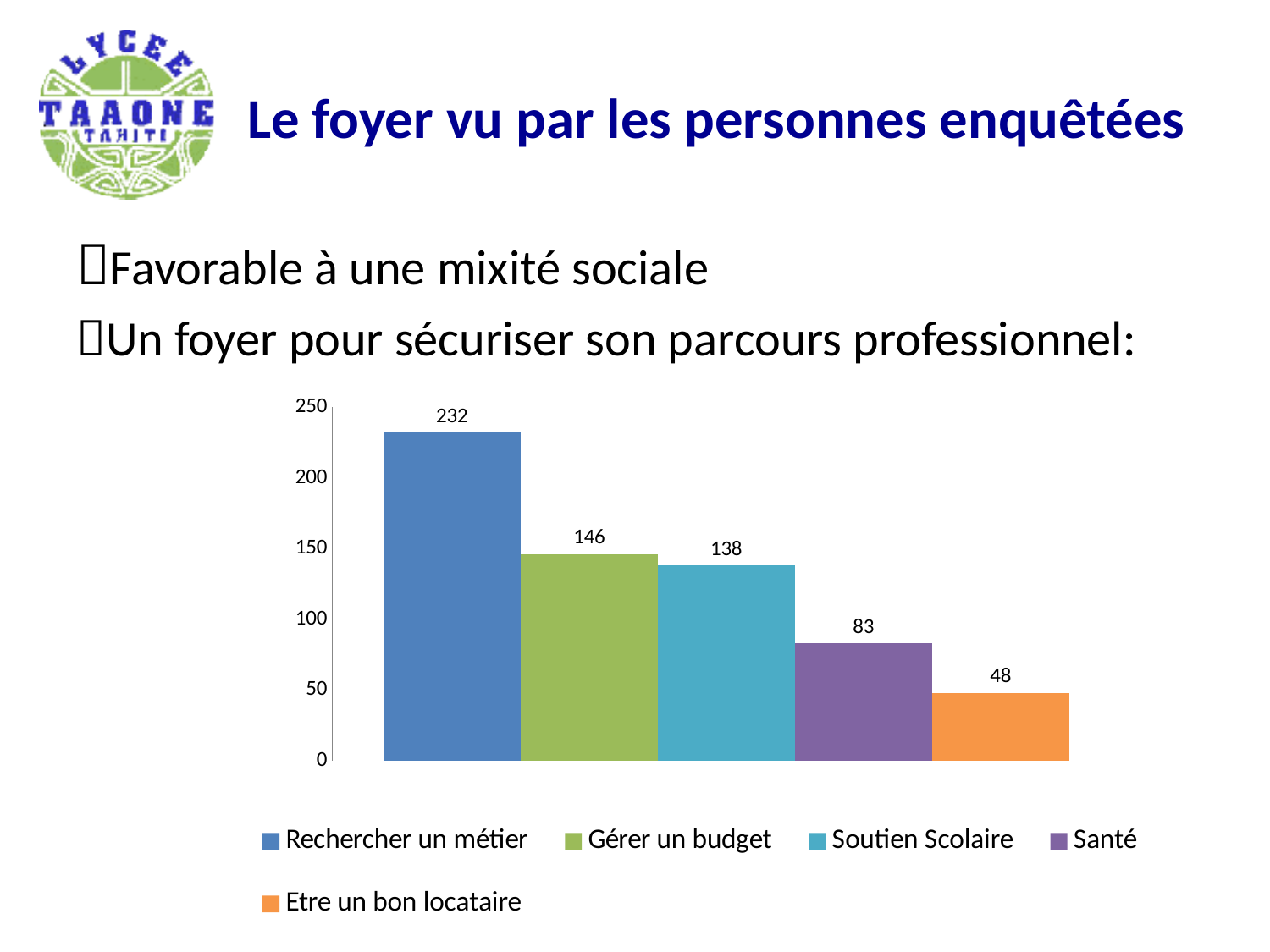
What is the value for Soutien Scolaire? 138 What is the value for Santé? 83 Which category has the lowest value? Etre un bon locataire What is the value for Gérer un budget? 146 What kind of chart is shown on the slide? Bar chart What is the value for Etre un bon locataire? 48 Which category has the highest value? Rechercher un métier Which is larger, the value for Santé or the value for Etre un bon locataire? Santé How many entries does the legend list? 5 What is the difference between the values for Rechercher un métier and Gérer un budget? 86 What is the value for Rechercher un métier? 232 How many bars are shown in the chart? 5